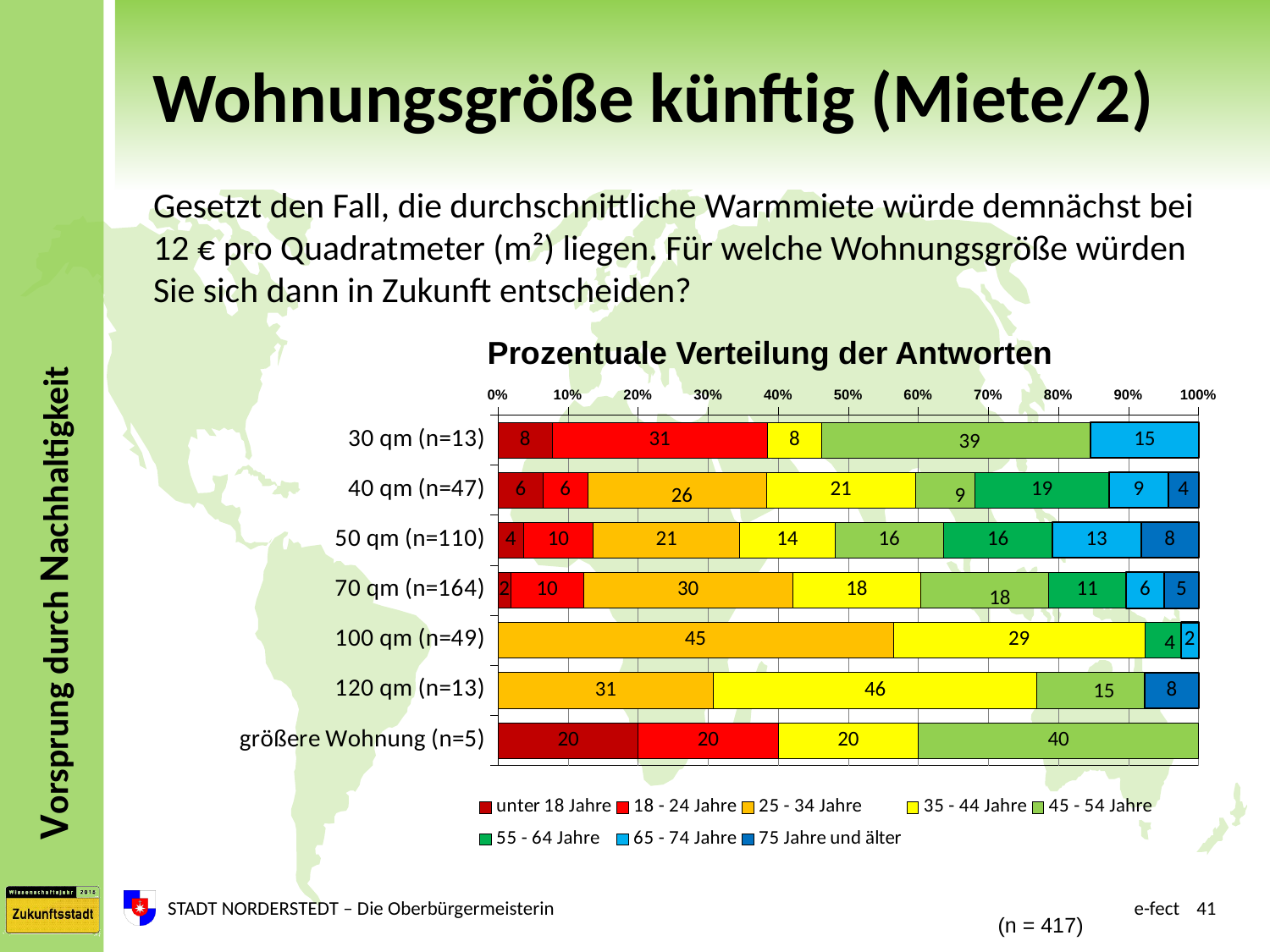
In the 120 qm (n=13) bar, what is the difference between the 35 - 44 Jahre value and the 25 - 34 Jahre value? 15 In the 30 qm (n=13) bar, which is larger: the value for 18 - 24 Jahre or the value for 45 - 54 Jahre? 45 - 54 Jahre What kind of chart is shown on the slide? Stacked bar chart How many apartment-size categories are plotted on the chart? 7 What is the value for 35 - 44 Jahre in the 120 qm (n=13) bar? 46 What is the value for 45 - 54 Jahre in the 30 qm (n=13) bar? 39 What is the title of the chart? Prozentuale Verteilung der Antworten What is the value for 75 Jahre und älter in the 40 qm (n=47) bar? 4 What is the value for 45 - 54 Jahre in the größere Wohnung (n=5) bar? 40 How many series does the legend list? 8 What is the value for 25 - 34 Jahre in the 70 qm (n=164) bar? 30 Which apartment-size category has the largest value for 35 - 44 Jahre? 120 qm (n=13)